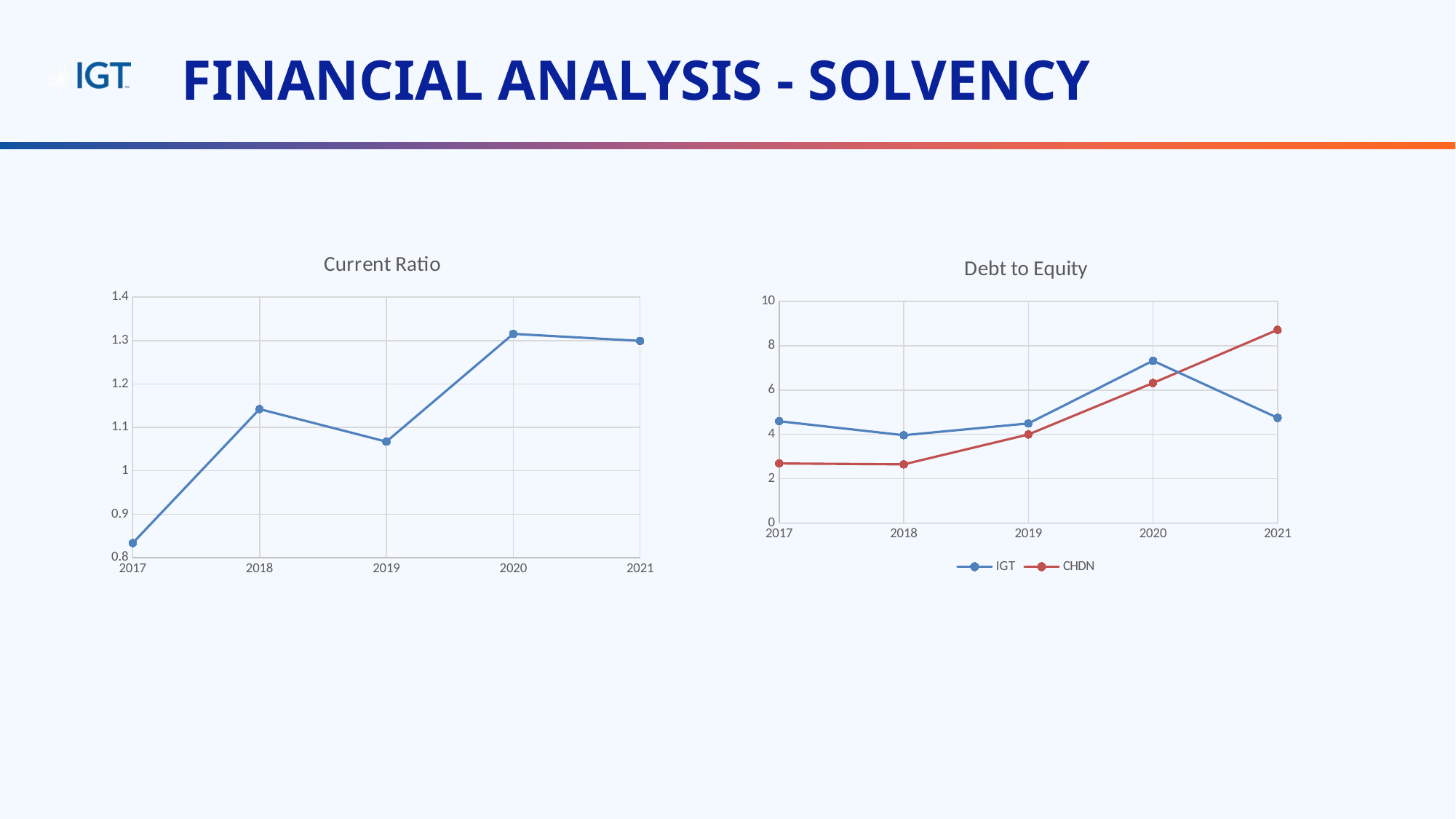
On the Current Ratio chart, is the value for 2018 greater or less than 1.1? greater On the Current Ratio chart, is the value for 2019 greater or less than 1? greater On the Debt to Equity chart, in which year is CHDN's debt to equity highest? 2021 How many years are plotted on the Current Ratio chart? 5 On the Current Ratio chart, is the value for 2017 greater or less than 0.9? less How many series does the legend of the Debt to Equity chart list? 2 On the Debt to Equity chart, in which year is IGT's debt to equity highest? 2020 On the Current Ratio chart, which year has the lowest current ratio? 2017 On the Current Ratio chart, is the value for 2018 larger or smaller than the value for 2019? larger What kind of chart is the Current Ratio chart? line chart On the Debt to Equity chart, which series has the larger value in 2021, IGT or CHDN? CHDN